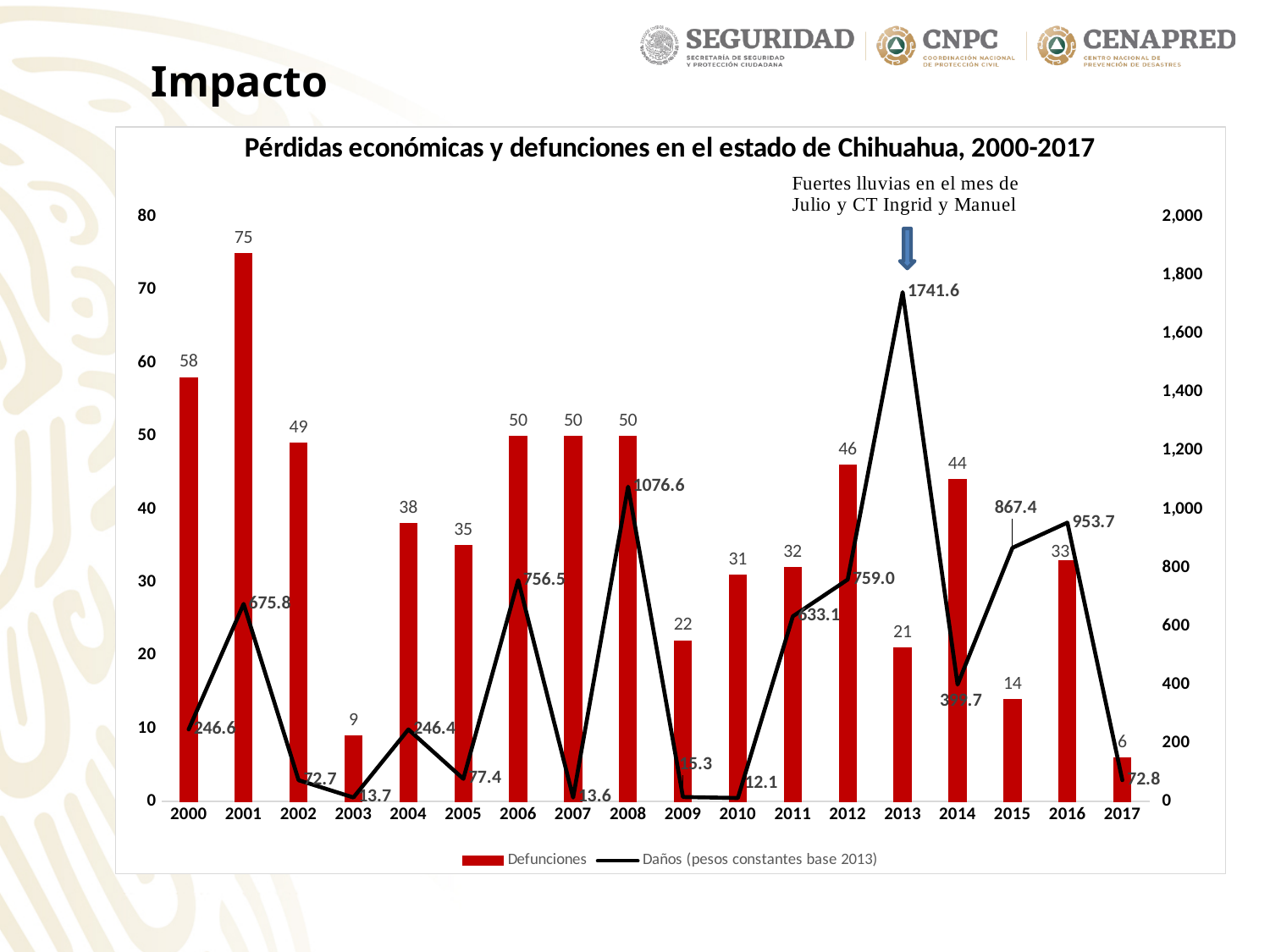
What is the value of Daños (pesos constantes base 2013) for 2015? 867.4 How many years are shown on the x axis? 18 How many series does the legend list? 2 Which year has the lowest number of Defunciones? 2017 Which is larger, the Daños value for 2008 or for 2016? 2008 Which year has the highest number of Defunciones? 2001 What is the value of Daños (pesos constantes base 2013) for 2013? 1741.6 What is the difference in Defunciones between 2000 and 2003? 49 Which year has the highest value of Daños (pesos constantes base 2013)? 2013 What kind of chart is used to show Defunciones? bar chart What is the title of the chart? Pérdidas económicas y defunciones en el estado de Chihuahua, 2000-2017 What is the value of Defunciones for 2001? 75